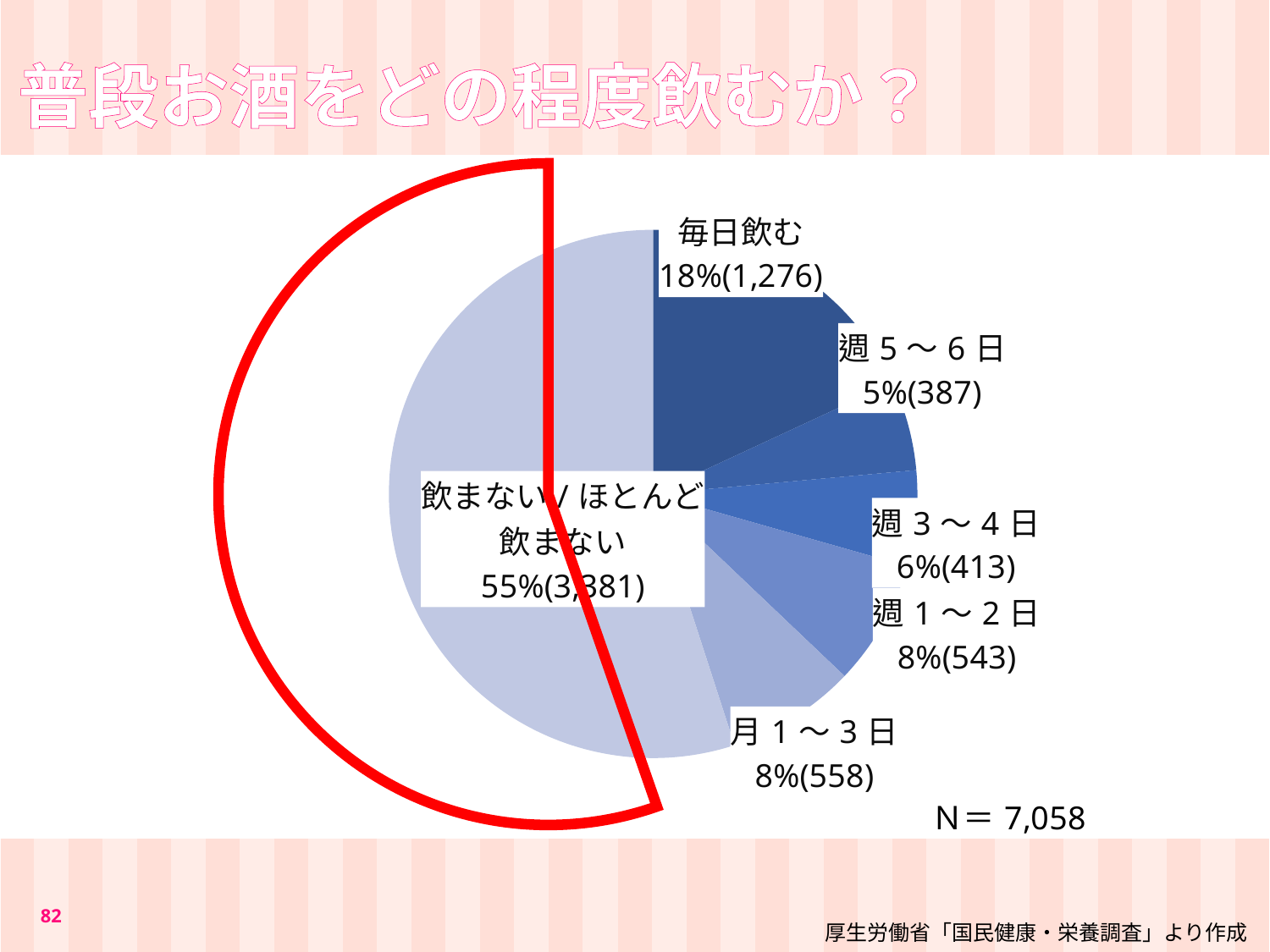
What kind of chart is shown on the slide? pie chart How many respondents are in the 毎日飲む category? 1,276 What share of the pie does 毎日飲む represent? 18% Which category has the smallest share of the pie? 週５～６日 What percentage is shown for 週５～６日? 5% What is the difference in respondent count between 月１～３日 and 週１～２日? 15 What is the difference in percentage points between 毎日飲む and 週１～２日? 10 Which category has the largest share of the pie? 飲まない / ほとんど飲まない How many respondents are in the 週３～４日 category? 413 What is the total number of respondents (N) shown on the slide? 7,058 Which is larger, the share for 週３～４日 or for 週５～６日? 週３～４日 How many categories does the pie chart have? 6